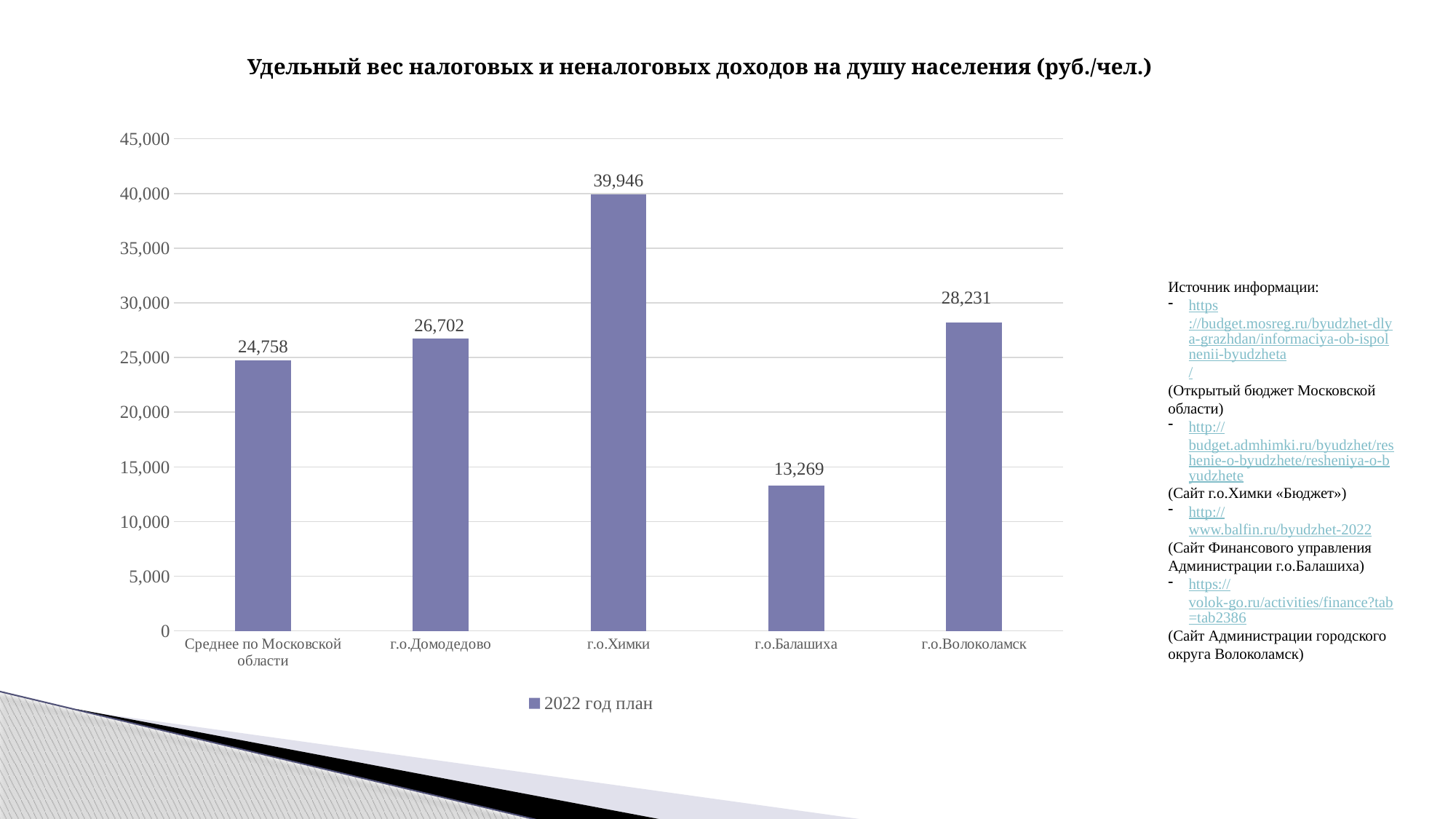
Which is larger, the value for г.о.Домодедово or the value for г.о.Волоколамск? г.о.Волоколамск What is the difference between the values for г.о.Химки and г.о.Балашиха? 26,677 What is the difference between the values for г.о.Волоколамск and г.о.Домодедово? 1,529 What kind of chart is shown? bar chart How many categories are shown on the x axis? 5 Which category has the lowest value? г.о.Балашиха Is the value for г.о.Балашиха greater or less than 15,000? less Which category has the highest value? г.о.Химки What is the value for г.о.Балашиха? 13,269 How many series does the legend list? 1 What is the value for г.о.Химки? 39,946 What is the value for Среднее по Московской области? 24,758